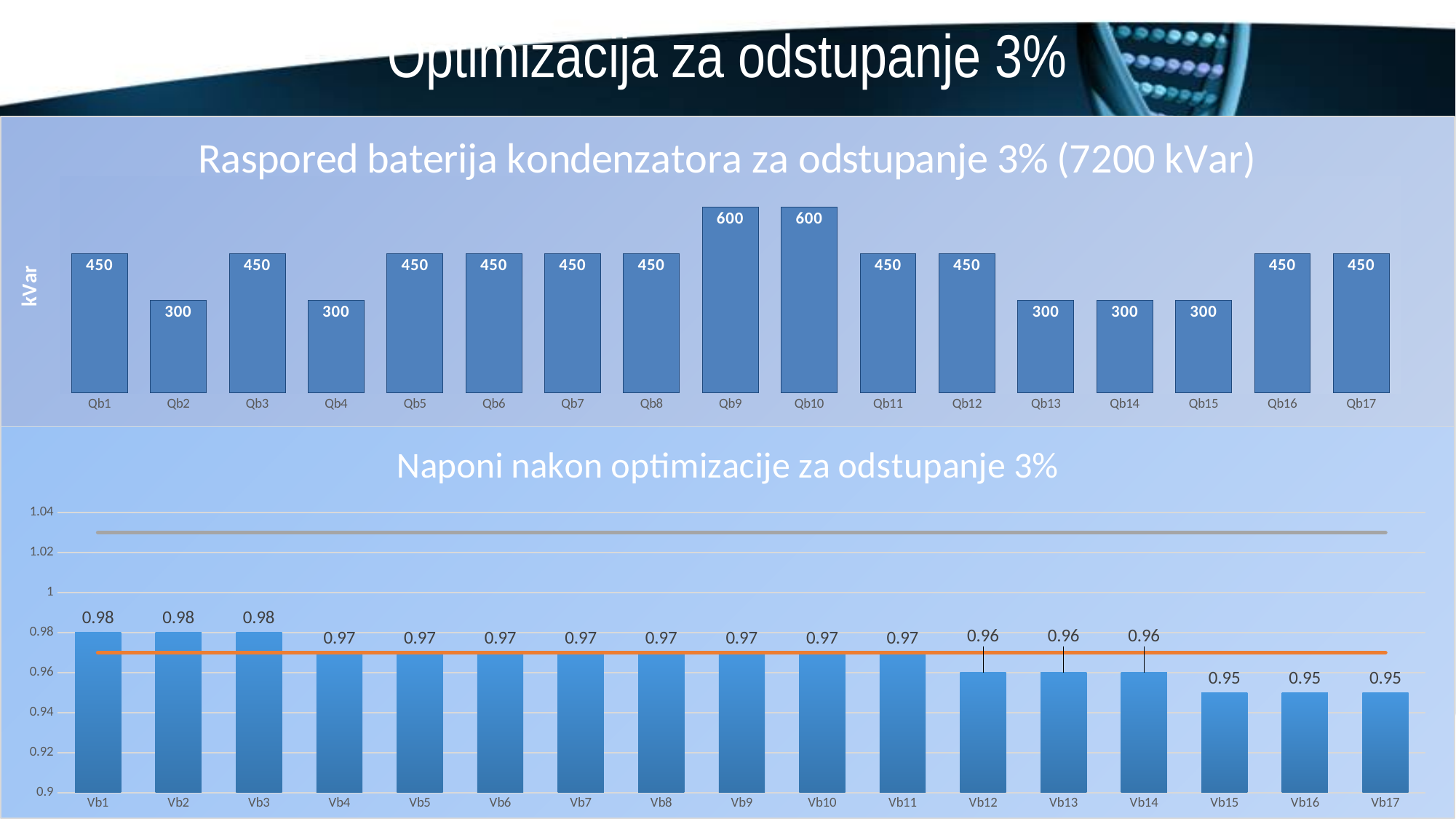
In the top chart 'Raspored baterija kondenzatora za odstupanje 3% (7200 kVar)', how many categories are shown on the x axis? 17 In the top chart 'Raspored baterija kondenzatora za odstupanje 3% (7200 kVar)', what is the difference between the values for Qb10 and Qb2? 300 In the bottom chart 'Naponi nakon optimizacije za odstupanje 3%', what is the value for Vb12? 0.96 In the top chart 'Raspored baterija kondenzatora za odstupanje 3% (7200 kVar)', which is larger, the value for Qb4 or the value for Qb5? Qb5 In the top chart 'Raspored baterija kondenzatora za odstupanje 3% (7200 kVar)', what is the label on the vertical axis? kVar In the top chart 'Raspored baterija kondenzatora za odstupanje 3% (7200 kVar)', what is the value for Qb13? 300 In the top chart 'Raspored baterija kondenzatora za odstupanje 3% (7200 kVar)', which categories have the highest value? Qb9 and Qb10 In the bottom chart 'Naponi nakon optimizacije za odstupanje 3%', which categories have the lowest value? Vb15, Vb16 and Vb17 In the bottom chart 'Naponi nakon optimizacije za odstupanje 3%', do the bar values rise or fall from Vb1 to Vb17? fall In the bottom chart 'Naponi nakon optimizacije za odstupanje 3%', what is the value for Vb1? 0.98 What kind of chart is the bottom chart 'Naponi nakon optimizacije za odstupanje 3%'? combination bar and line chart In the top chart 'Raspored baterija kondenzatora za odstupanje 3% (7200 kVar)', what is the value for Qb9? 600